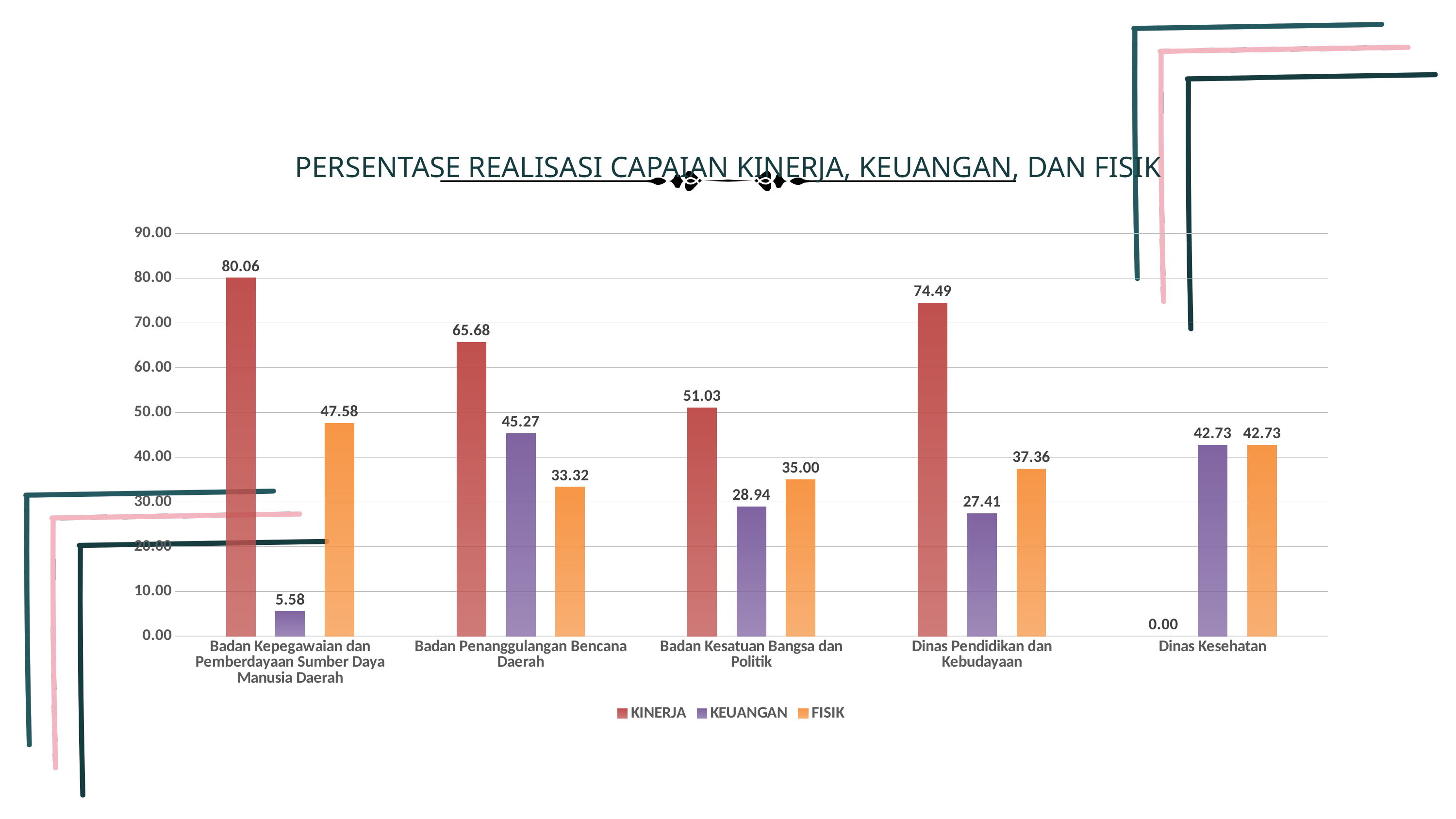
What is the KEUANGAN value for Badan Penanggulangan Bencana Daerah? 45.27 What is the difference between the KINERJA and KEUANGAN values for Badan Kesatuan Bangsa dan Politik? 22.09 What kind of chart is shown on the slide? Bar chart What is the FISIK value for Dinas Pendidikan dan Kebudayaan? 37.36 What is the KINERJA value for Dinas Kesehatan? 0.00 What is the KINERJA value for Badan Kepegawaian dan Pemberdayaan Sumber Daya Manusia Daerah? 80.06 How many series does the legend list? 3 How many categories are shown on the x axis? 5 For Badan Penanggulangan Bencana Daerah, which is larger: the KEUANGAN value or the FISIK value? KEUANGAN Which category has the lowest KEUANGAN value? Badan Kepegawaian dan Pemberdayaan Sumber Daya Manusia Daerah What is the title of the chart? PERSENTASE REALISASI CAPAIAN KINERJA, KEUANGAN, DAN FISIK Which category has the highest KINERJA value? Badan Kepegawaian dan Pemberdayaan Sumber Daya Manusia Daerah